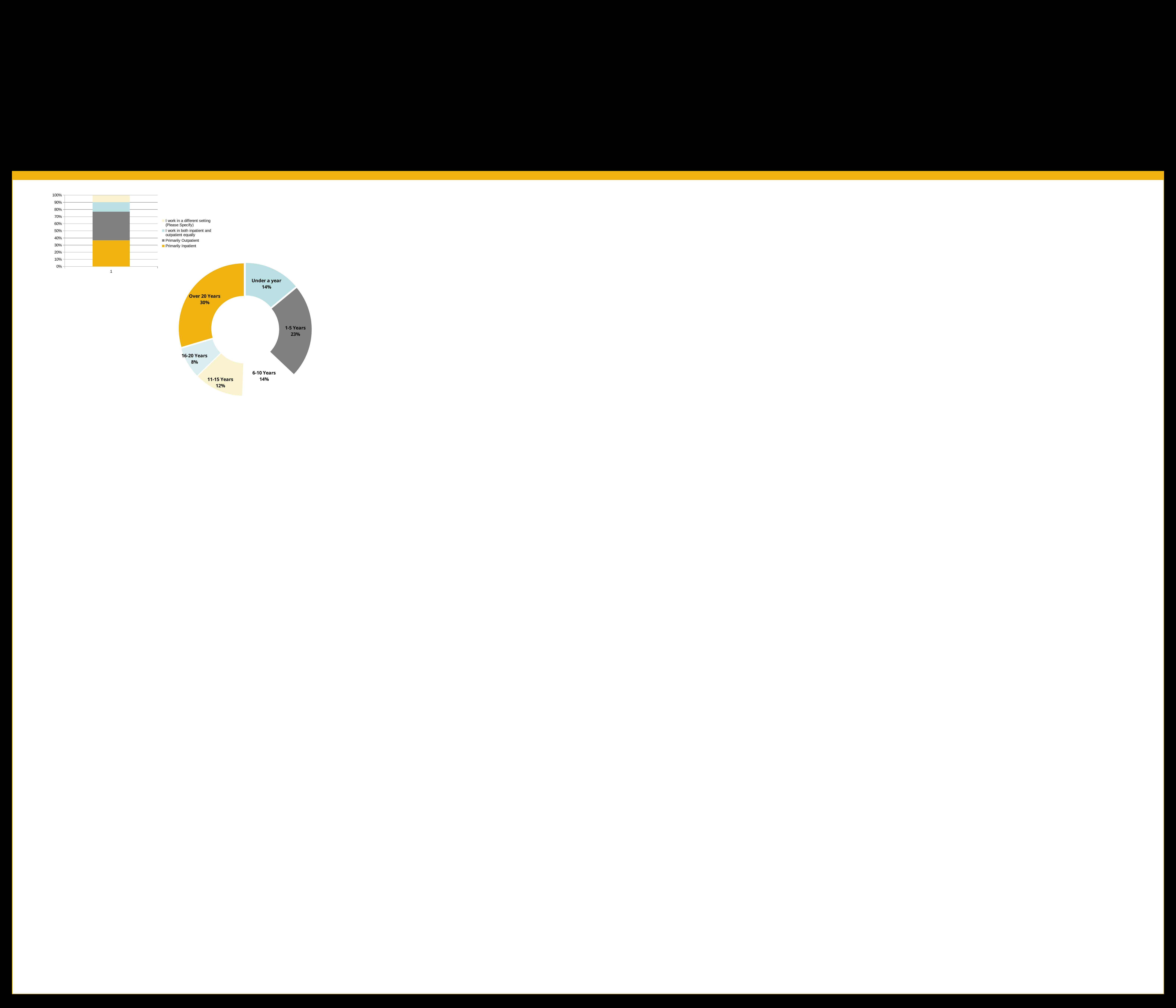
In the doughnut chart, which is larger: 11-15 Years or 6-10 Years? 6-10 Years In the doughnut chart, which category has the smallest share? 16-20 Years In the doughnut chart, what is the difference in percentage points between Over 20 Years and 1-5 Years? 7 In the stacked bar chart on the left, is the top of the Primarily Inpatient segment greater or less than 50%? less How many categories are shown in the doughnut chart? 6 In the doughnut chart, what share is labelled for 11-15 Years? 12% What kind of chart is the chart on the left of the slide? Stacked bar chart In the doughnut chart, which category has the largest share? Over 20 Years How many series does the legend of the stacked bar chart on the left list? 4 In the doughnut chart, what share is labelled for Over 20 Years? 30% In the doughnut chart, what share is labelled for 1-5 Years? 23% In the doughnut chart, what share is labelled for 16-20 Years? 8%